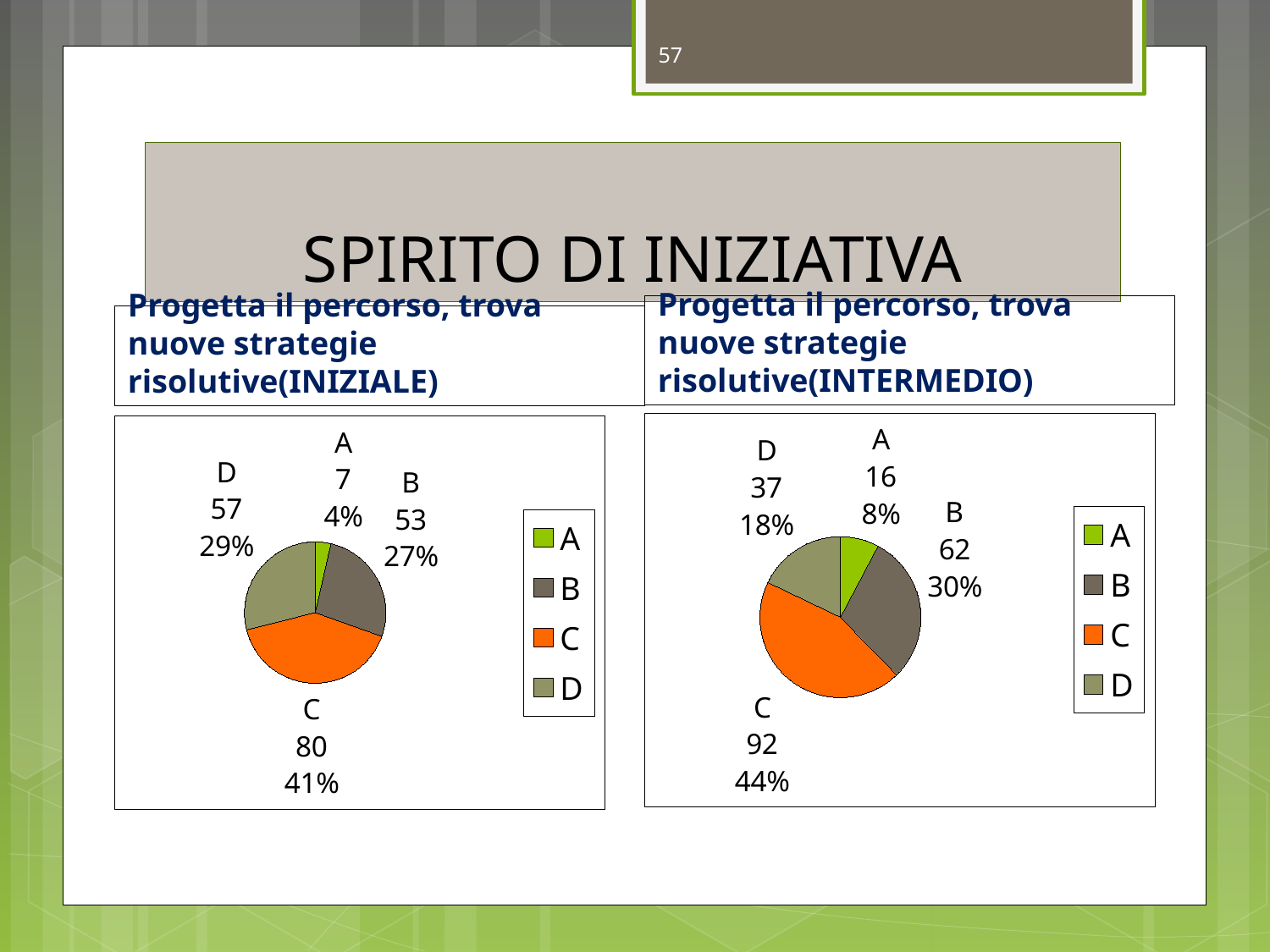
In the left pie chart (INIZIALE), what is the difference between the values for D and B? 4 What type of chart is used on the right side of the slide (INTERMEDIO)? Pie chart How many categories does the left pie chart (INIZIALE) show? 4 In the right pie chart (INTERMEDIO), what percentage share does category A have? 8% In the left pie chart (INIZIALE), what percentage share does category D have? 29% In the right pie chart (INTERMEDIO), what is the value for category B? 62 In the right pie chart (INTERMEDIO), what is the difference between the values for C and D? 55 How many entries does the legend of the left chart (INIZIALE) list? 4 In the left pie chart (INIZIALE), what is the value for category C? 80 In the left pie chart (INIZIALE), which category has the largest slice? C In the right pie chart (INTERMEDIO), which is larger, the value for B or the value for D? B In the right pie chart (INTERMEDIO), which category has the smallest slice? A